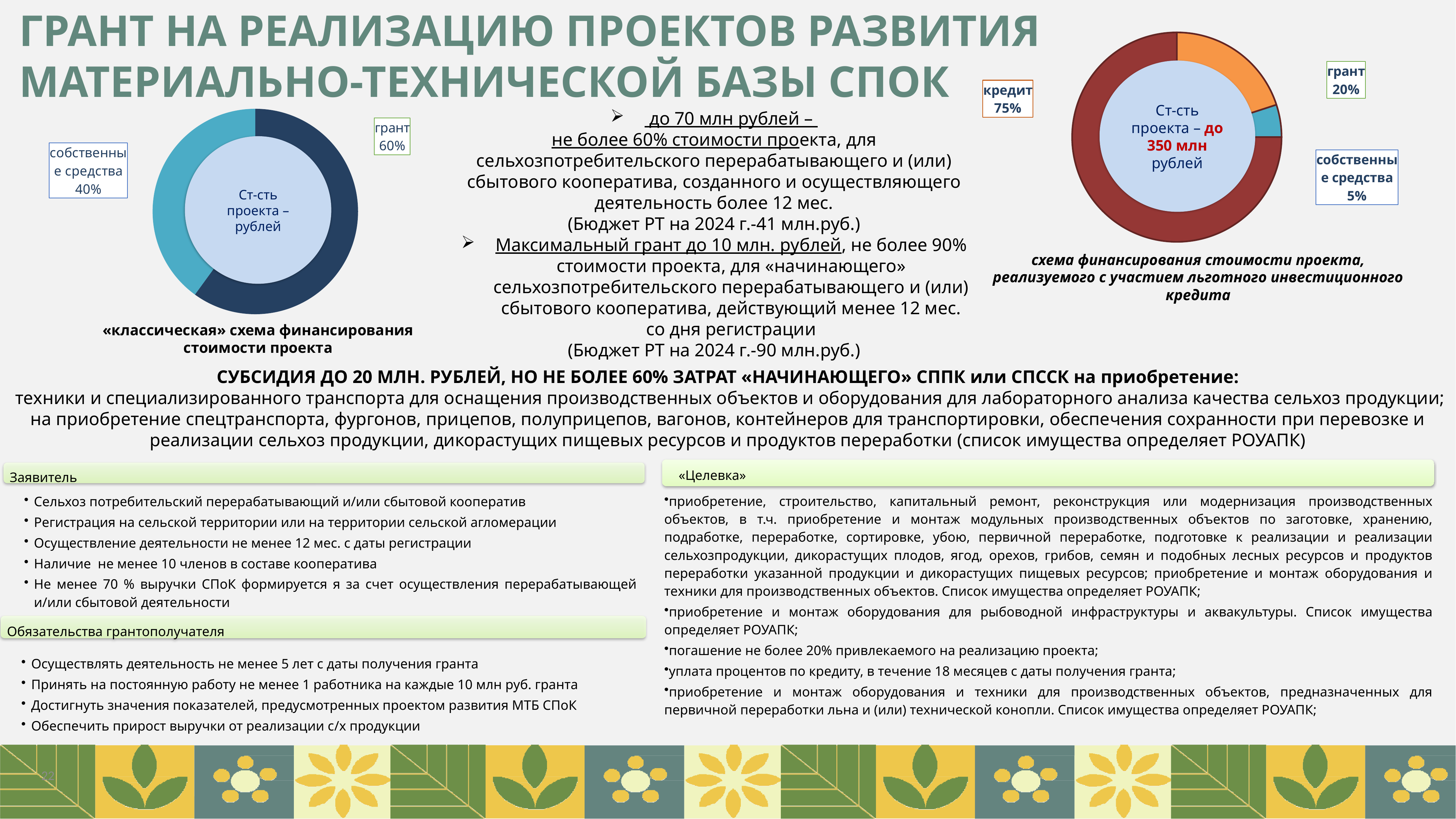
На левой диаграмме («классическая» схема) что больше: доля гранта или доля собственных средств? грант На правой диаграмме (схема с льготным кредитом) на сколько процентных пунктов доля кредита больше доли гранта? 55% На левой диаграмме («классическая» схема финансирования) какая доля приходится на собственные средства? 40% На левой диаграмме («классическая» схема финансирования стоимости проекта) какая доля приходится на грант? 60% На правой диаграмме (схема с льготным кредитом) какая доля приходится на грант? 20% На левой диаграмме («классическая» схема) на сколько процентных пунктов доля гранта больше доли собственных средств? 20% На правой диаграмме (схема финансирования с участием льготного инвестиционного кредита) какая доля приходится на кредит? 75% На правой диаграмме (схема с льготным кредитом) какой источник финансирования имеет наибольшую долю? кредит Сколько сегментов на правой диаграмме (схема с льготным кредитом)? 3 На правой диаграмме (схема с льготным кредитом) какой источник финансирования имеет наименьшую долю? собственные средства Какого типа диаграммы показаны на слайде? кольцевые (круговые) диаграммы На правой диаграмме (схема с льготным кредитом) какая доля приходится на собственные средства? 5%